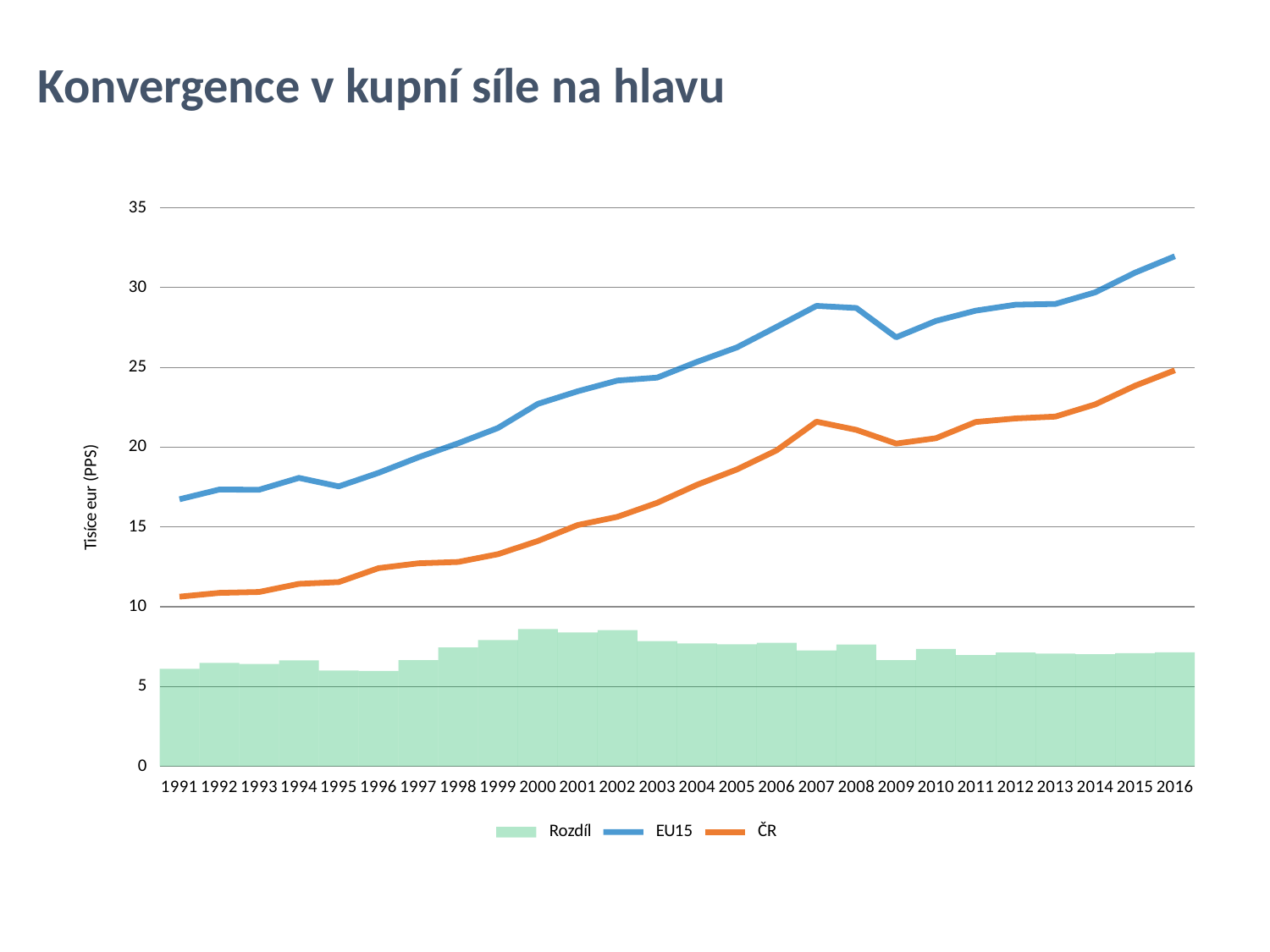
Does the ČR series generally rise or fall from 1991 to 2016? rise In which year is the EU15 series at its highest? 2016 Is the value for ČR in 1991 greater or less than 15? less Is the value for ČR in 2007 greater or less than 20? greater What is the label on the vertical axis? Tisíce eur (PPS) How many years are shown on the x axis? 26 Which series is larger in 2016, EU15 or ČR? EU15 What are the names of the series in the legend? Rozdíl, EU15, ČR How many series does the legend list? 3 In which year is the EU15 series at its lowest? 1991 Is the value for EU15 in 2016 greater or less than 30? greater In which year is the ČR series at its lowest? 1991